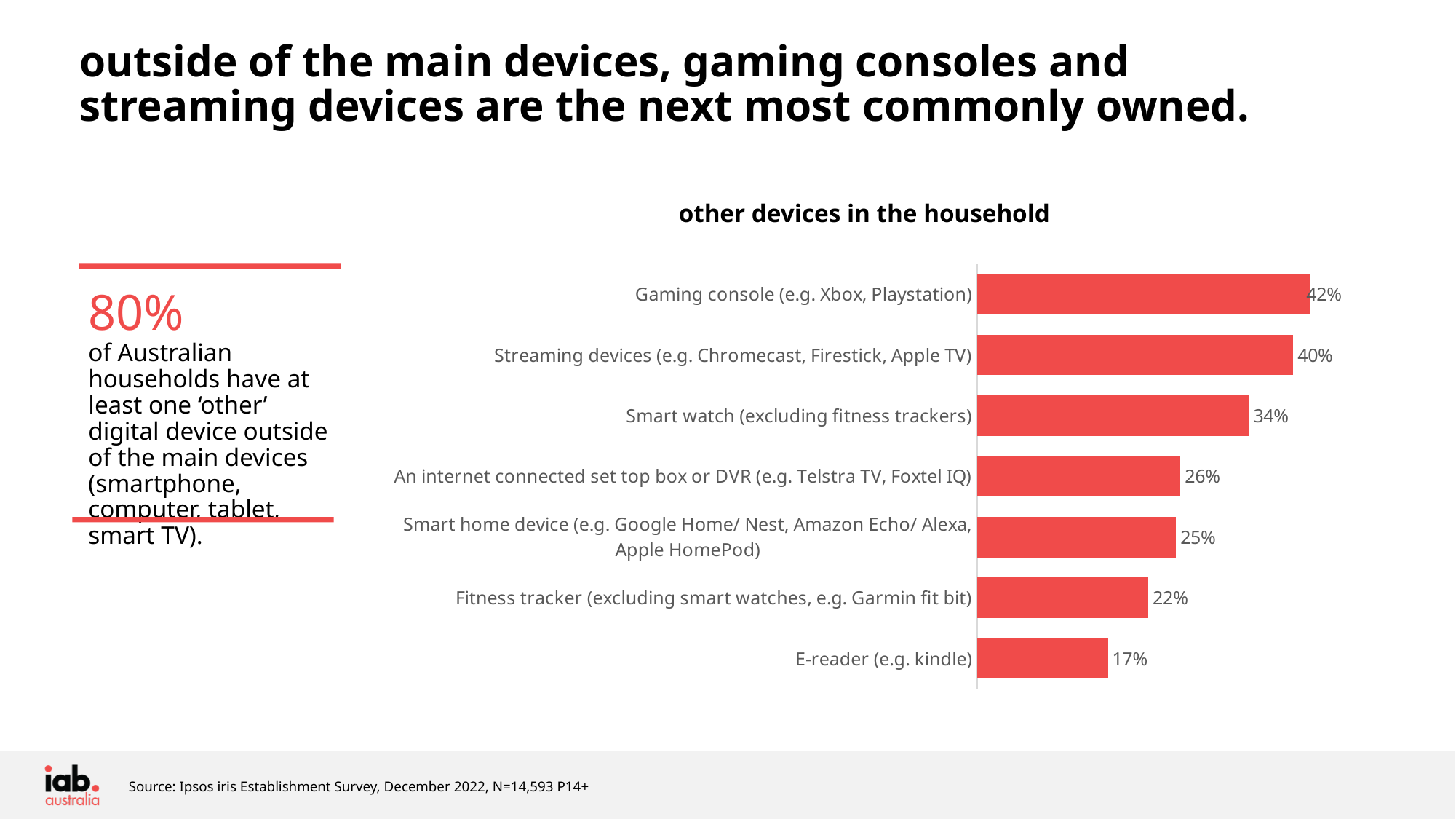
What is the title of the chart? other devices in the household What is the value for smart home devices (e.g. Google Home/ Nest, Amazon Echo/ Alexa, Apple HomePod)? 25% What type of chart is used to show other devices in the household? Bar chart What is the value shown for streaming devices (e.g. Chromecast, Firestick, Apple TV)? 40% What percentage of households own a gaming console (e.g. Xbox, Playstation)? 42% What percentage of households have an e-reader (e.g. kindle)? 17% Which device category has the highest value in the chart? Gaming console (e.g. Xbox, Playstation) Which device category has the lowest value in the chart? E-reader (e.g. kindle) What is the difference in percentage points between gaming consoles and e-readers? 25 How many device categories are shown in the chart? 7 Which is larger: the value for an internet connected set top box or DVR, or the value for a fitness tracker? An internet connected set top box or DVR What is the difference in percentage points between smart watches and fitness trackers? 12